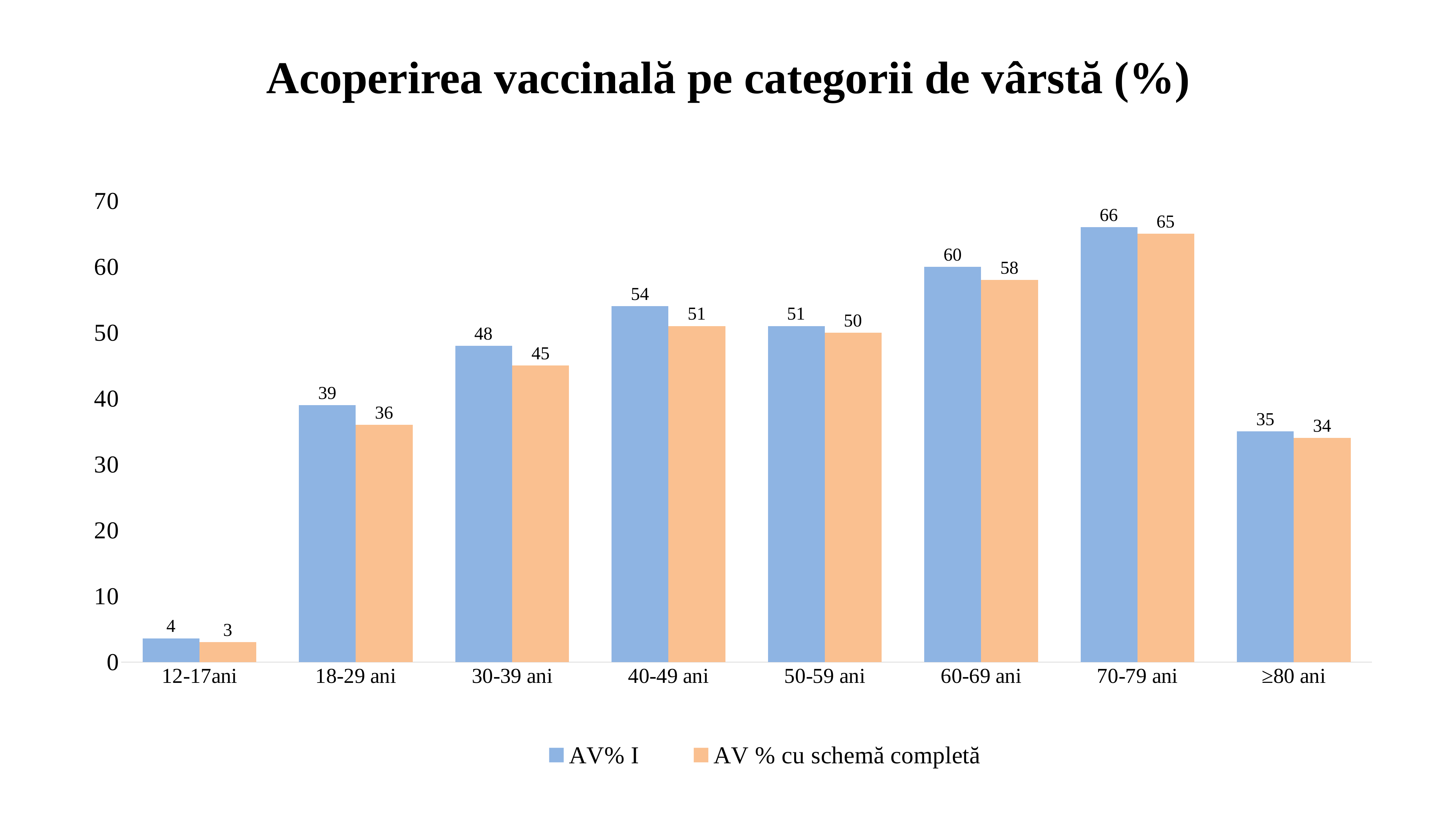
What is the difference between the AV% I and AV % cu schemă completă values for the 30-39 ani age group? 3 What is the AV % cu schemă completă value for the 18-29 ani age group? 36 How many series does the legend list? 2 Which is larger: the AV% I value for 60-69 ani or the AV% I value for ≥80 ani? 60-69 ani Which age group has the lowest AV % cu schemă completă value? 12-17ani What is the AV % cu schemă completă value for the 70-79 ani age group? 65 How many age groups are shown on the x axis? 8 What is the title of the chart? Acoperirea vaccinală pe categorii de vârstă (%) What is the AV% I value for the 40-49 ani age group? 54 Which age group has the highest AV% I value? 70-79 ani What kind of chart is shown on the slide? bar chart Which colour represents the AV % cu schemă completă series? orange